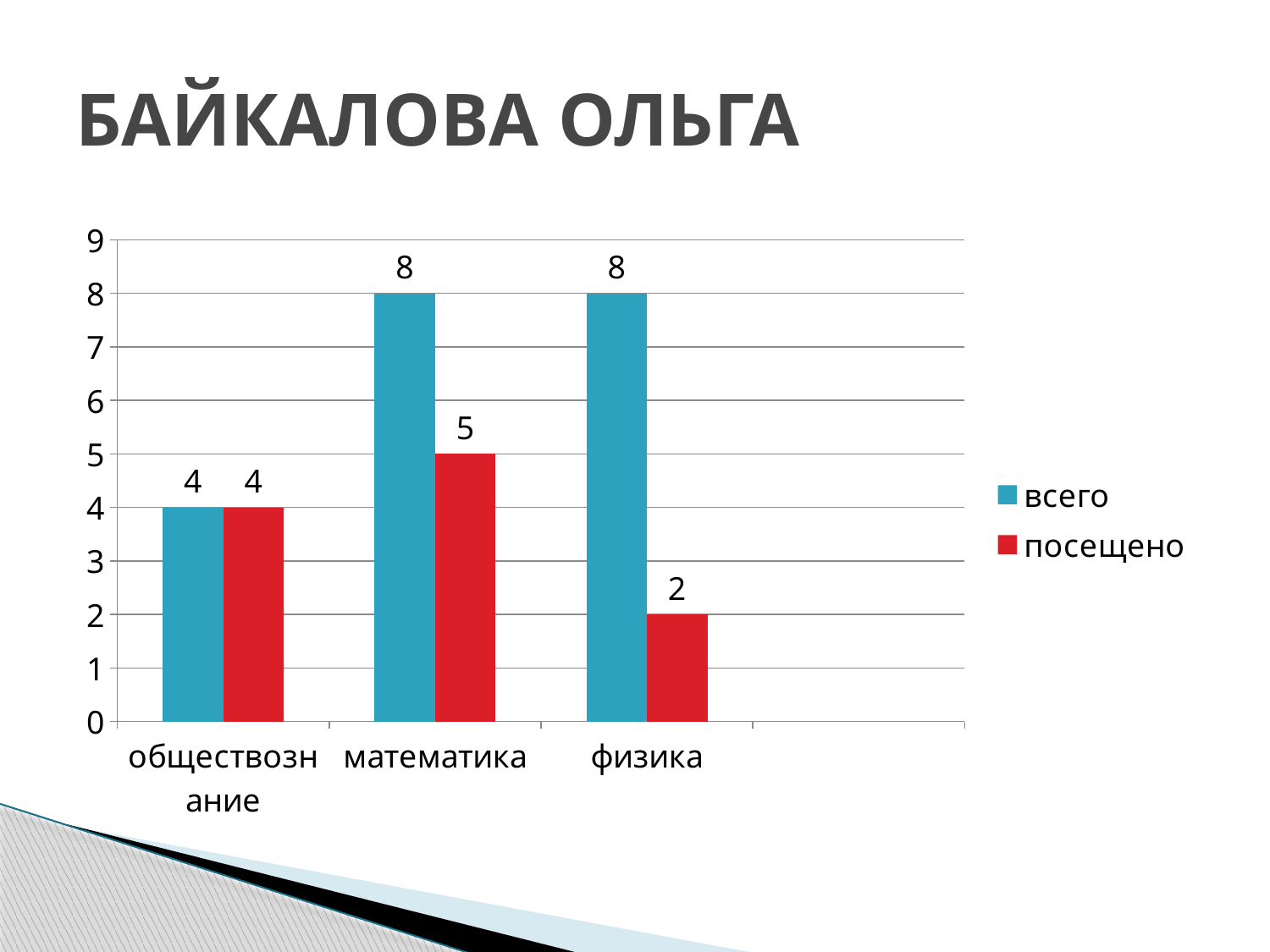
What kind of chart is shown on the slide? bar chart What colour are the "посещено" bars? red What is the difference between "всего" and "посещено" for физика? 6 How many series does the legend list? 2 What is the value of "всего" for математика? 8 Which category has the lowest "посещено" value? физика How many categories are shown on the x axis? 3 Which category has the highest "посещено" value? математика What is the value of "посещено" for обществознание? 4 What is the value of "посещено" for физика? 2 What is the difference between "всего" and "посещено" for математика? 3 Which is larger: "посещено" for математика or "посещено" for физика? математика